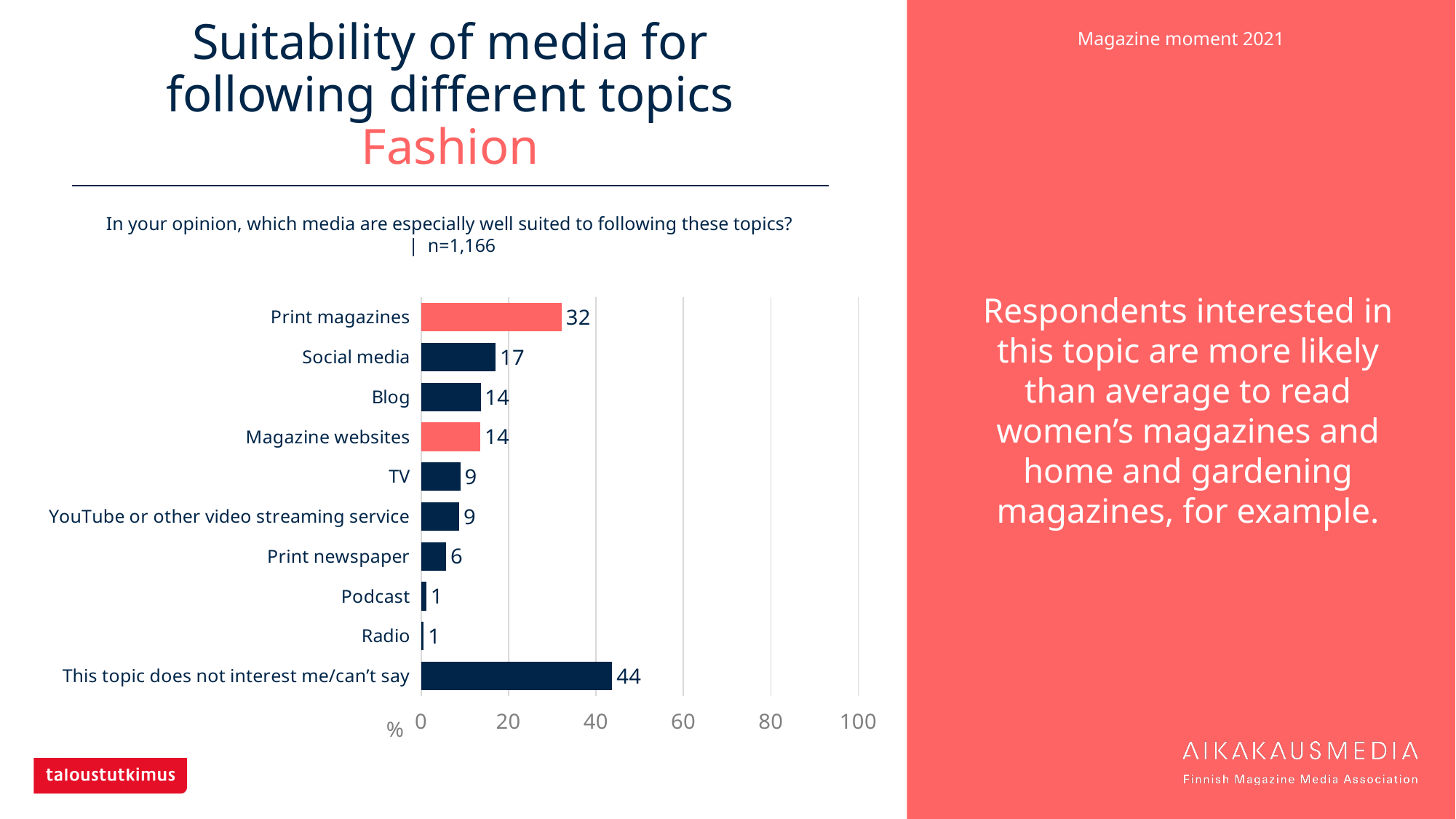
What is the value for 'This topic does not interest me/can't say'? 44 Which media category (excluding the 'does not interest me/can't say' option) has the highest value? Print magazines What is the value for Social media? 17 How many categories are shown in the chart? 10 What is the difference between the values for Print magazines and Social media? 15 What kind of chart is shown on the slide? Bar chart Is the value for Print magazines greater or less than 40? less Which category has the highest value? This topic does not interest me/can't say Which two categories are shown with red bars? Print magazines and Magazine websites What is the value for Print newspaper? 6 What is the value for Print magazines? 32 Which is larger, the value for Blog or the value for TV? Blog